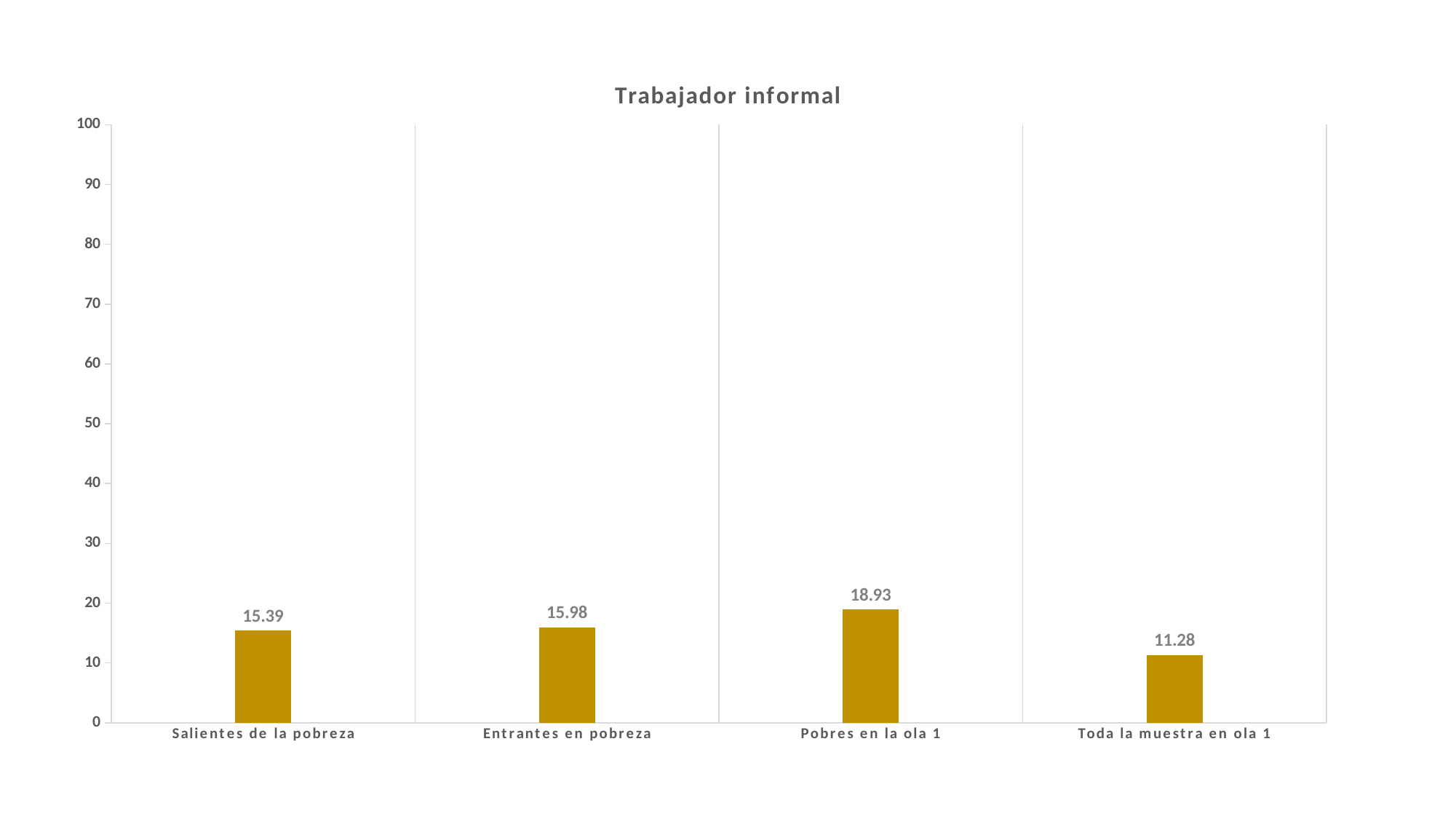
What is the value for Toda la muestra en ola 1? 11.28 What is the difference between the values for Entrantes en pobreza and Salientes de la pobreza? 0.59 What is the value for Entrantes en pobreza? 15.98 Which category has the lowest value? Toda la muestra en ola 1 What is the difference between the values for Pobres en la ola 1 and Toda la muestra en ola 1? 7.65 Which is larger, the value for Pobres en la ola 1 or the value for Salientes de la pobreza? Pobres en la ola 1 What kind of chart is shown on the slide? bar chart How many categories are shown on the x axis? 4 Which category has the highest value? Pobres en la ola 1 Is the value for Toda la muestra en ola 1 greater or less than 20? less What is the value for Salientes de la pobreza? 15.39 What is the value for Pobres en la ola 1? 18.93